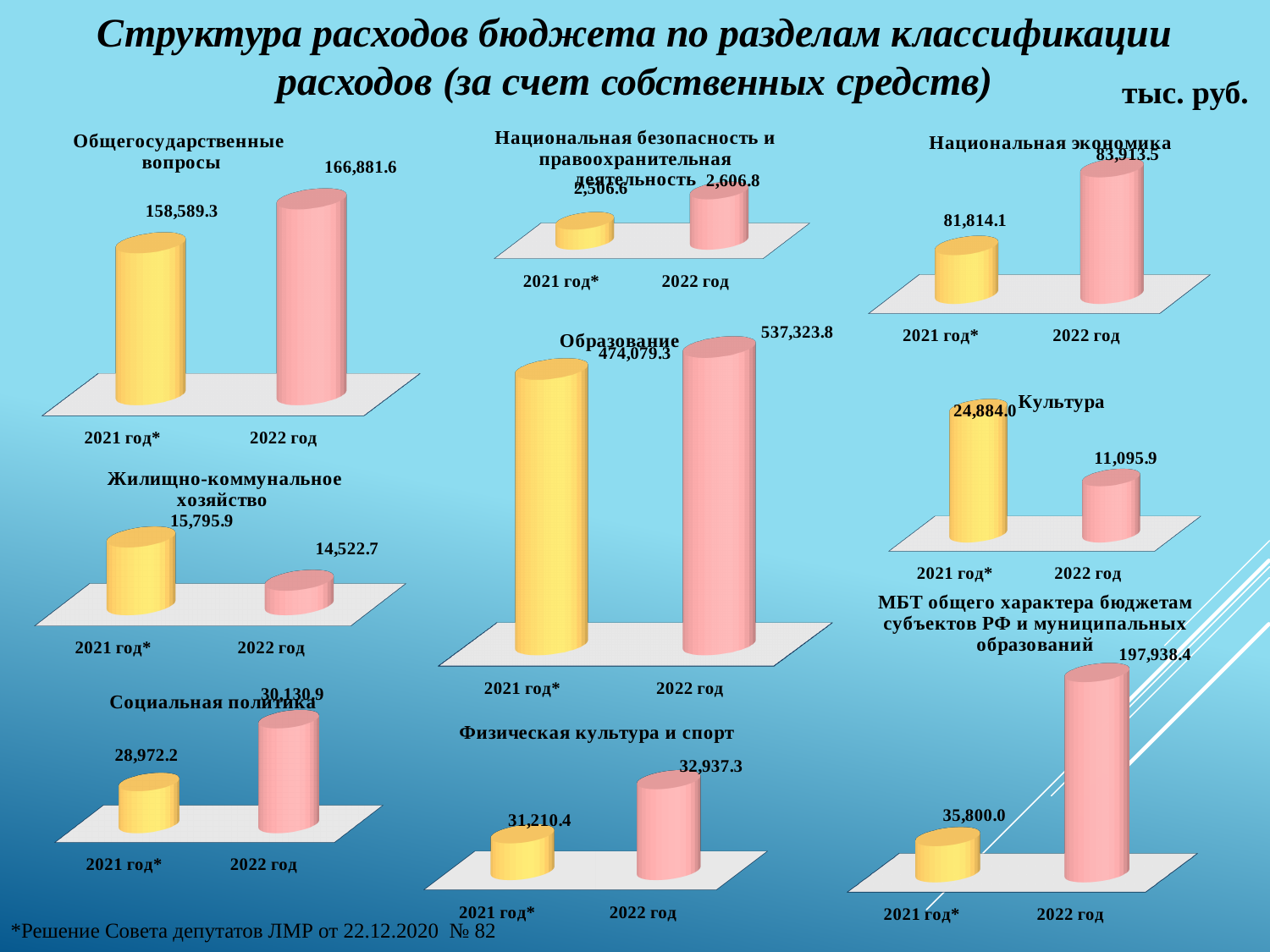
In the chart titled "МБТ общего характера бюджетам субъектов РФ и муниципальных образований", what is the difference between the 2022 год and 2021 год* values? 162,138.4 In the chart titled "Культура", which year has the higher value? 2021 год* In the chart titled "Жилищно-коммунальное хозяйство", which year has the lowest value? 2022 год In the chart titled "Общегосударственные вопросы", what is the value for 2022 год? 166,881.6 In the chart titled "Национальная экономика", what is the value for 2022 год? 83,913.5 What unit of measurement is stated at the top right of the slide? тыс. руб. In the chart titled "Образование", what is the value for 2021 год*? 474,079.3 In the chart titled "Образование", what is the difference between the 2022 год and 2021 год* values? 63,244.5 How many categories (years) are shown in the chart titled "Физическая культура и спорт"? 2 In the chart titled "Социальная политика", do the values rise or fall from 2021 год* to 2022 год? rise In the chart titled "Культура", how much larger is the 2021 год* value than the 2022 год value? 13,788.1 What kind of chart is used for "Национальная безопасность и правоохранительная деятельность"? bar chart